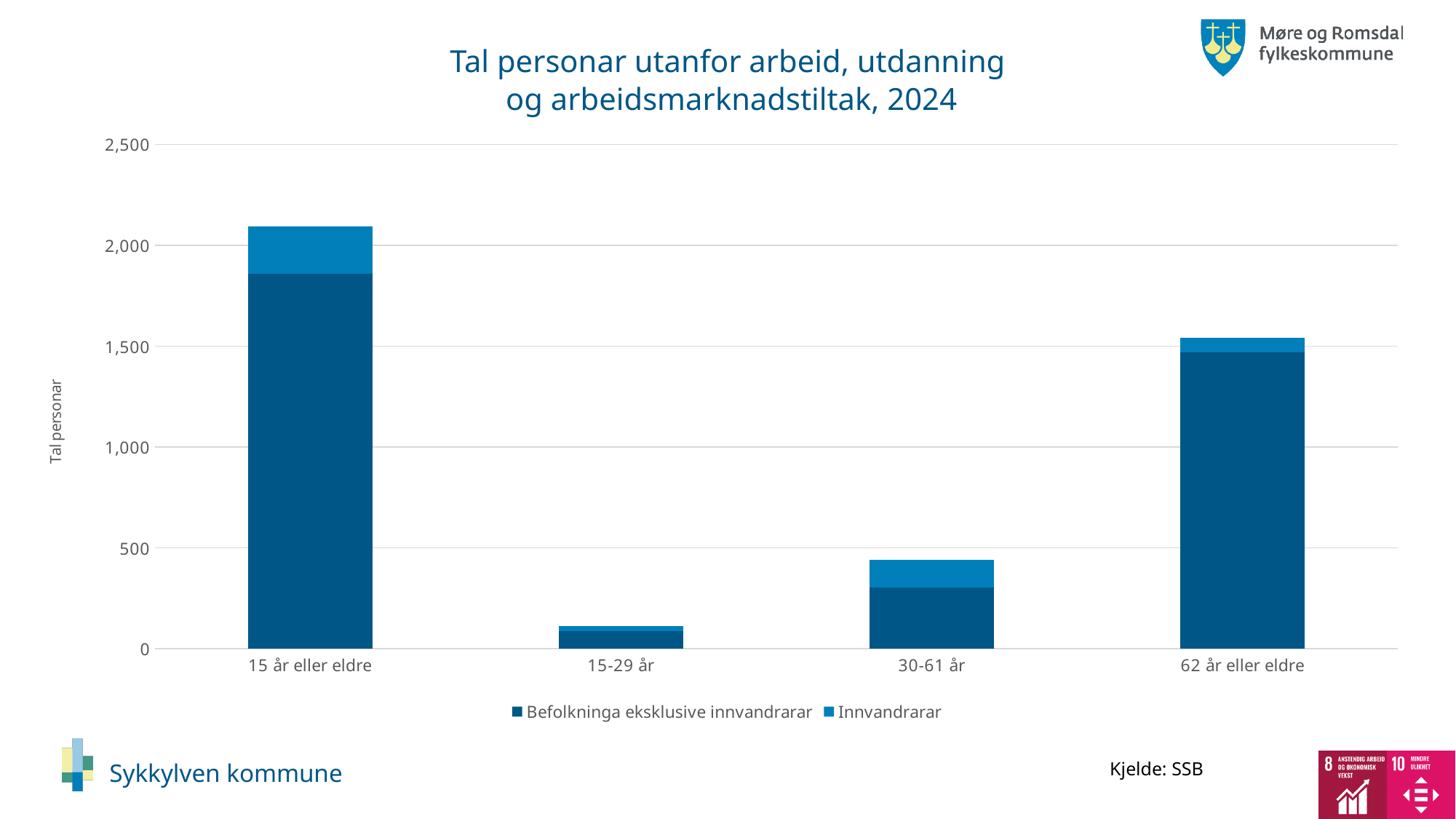
How many series does the legend list? 2 What kind of chart is shown on the slide? Stacked bar chart Is the Befolkninga eksklusive innvandrarar value for 15-29 år greater or less than 500? less Is the total value for 62 år eller eldre greater or less than 1,000? greater What is the title of the chart? Tal personar utanfor arbeid, utdanning og arbeidsmarknadstiltak, 2024 Is the total value for 15 år eller eldre greater or less than 2,000? greater How many age categories are shown on the x axis? 4 Which age category has the highest total bar? 15 år eller eldre Which has a larger total bar, 30-61 år or 15-29 år? 30-61 år Which age category has the lowest total bar? 15-29 år What is the label on the y axis? Tal personar